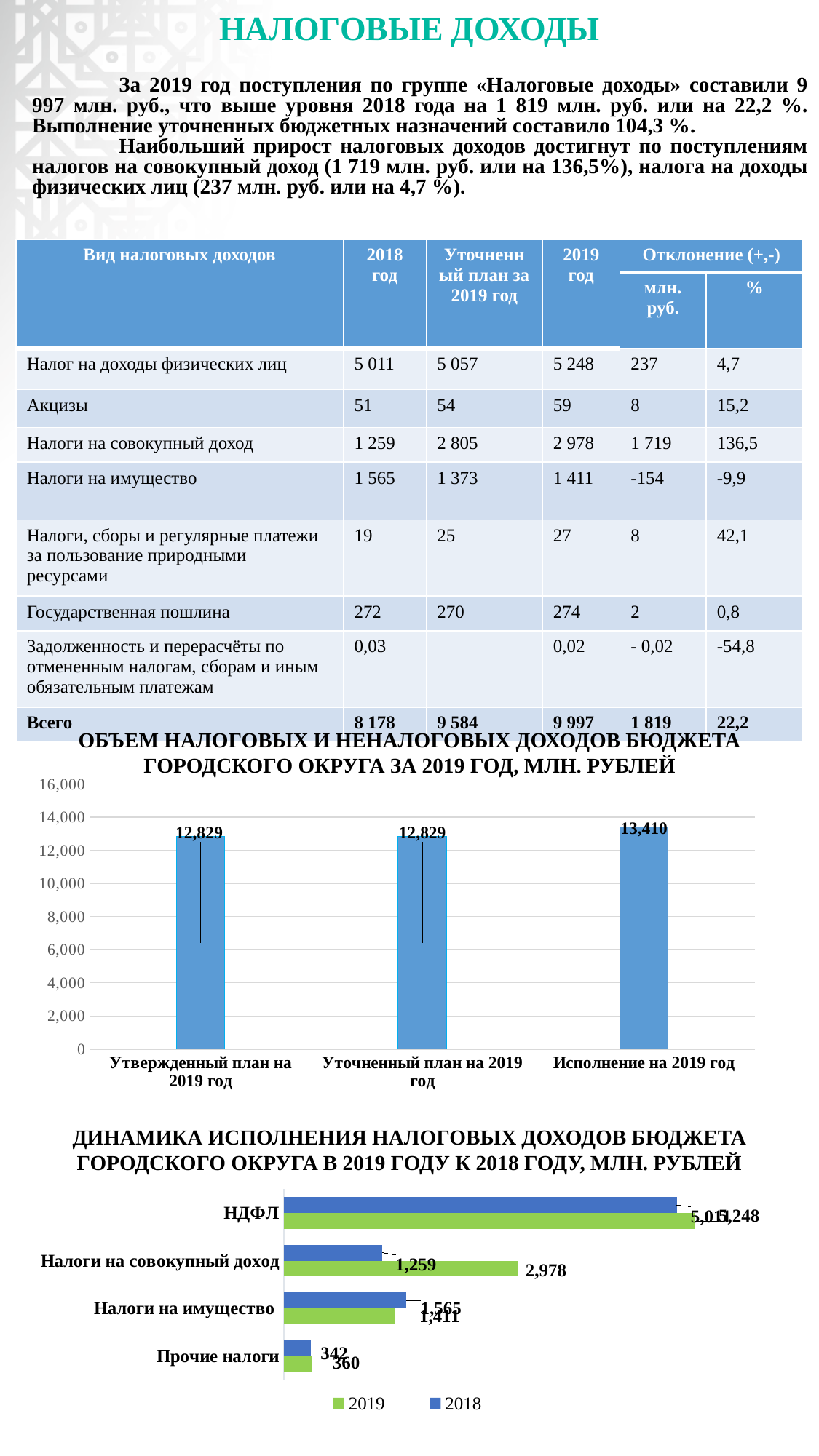
In the chart 'ОБЪЕМ НАЛОГОВЫХ И НЕНАЛОГОВЫХ ДОХОДОВ БЮДЖЕТА ГОРОДСКОГО ОКРУГА ЗА 2019 ГОД', what is the value for 'Утвержденный план на 2019 год'? 12,829 In the chart 'ОБЪЕМ НАЛОГОВЫХ И НЕНАЛОГОВЫХ ДОХОДОВ БЮДЖЕТА ГОРОДСКОГО ОКРУГА ЗА 2019 ГОД', which category has the highest value? Исполнение на 2019 год In the chart 'ОБЪЕМ НАЛОГОВЫХ И НЕНАЛОГОВЫХ ДОХОДОВ БЮДЖЕТА ГОРОДСКОГО ОКРУГА ЗА 2019 ГОД', what is the difference between 'Исполнение на 2019 год' and 'Уточненный план на 2019 год'? 581 In the chart 'ДИНАМИКА ИСПОЛНЕНИЯ НАЛОГОВЫХ ДОХОДОВ БЮДЖЕТА ГОРОДСКОГО ОКРУГА В 2019 ГОДУ К 2018 ГОДУ', which is larger for 'Налоги на совокупный доход': the 2018 value or the 2019 value? 2019 In the chart 'ОБЪЕМ НАЛОГОВЫХ И НЕНАЛОГОВЫХ ДОХОДОВ БЮДЖЕТА ГОРОДСКОГО ОКРУГА ЗА 2019 ГОД', what is the value for 'Исполнение на 2019 год'? 13,410 In the chart 'ДИНАМИКА ИСПОЛНЕНИЯ НАЛОГОВЫХ ДОХОДОВ БЮДЖЕТА ГОРОДСКОГО ОКРУГА В 2019 ГОДУ К 2018 ГОДУ', what is the 2019 value for 'Налоги на совокупный доход'? 2,978 In the chart 'ОБЪЕМ НАЛОГОВЫХ И НЕНАЛОГОВЫХ ДОХОДОВ БЮДЖЕТА ГОРОДСКОГО ОКРУГА ЗА 2019 ГОД', how many bars are plotted? 3 In the chart 'ДИНАМИКА ИСПОЛНЕНИЯ НАЛОГОВЫХ ДОХОДОВ БЮДЖЕТА ГОРОДСКОГО ОКРУГА В 2019 ГОДУ К 2018 ГОДУ', what is the difference between the 2019 and 2018 values for 'Налоги на совокупный доход'? 1,719 In the chart 'ДИНАМИКА ИСПОЛНЕНИЯ НАЛОГОВЫХ ДОХОДОВ БЮДЖЕТА ГОРОДСКОГО ОКРУГА В 2019 ГОДУ К 2018 ГОДУ', what is the 2018 value for 'Налоги на имущество'? 1,565 What kind of chart is 'ОБЪЕМ НАЛОГОВЫХ И НЕНАЛОГОВЫХ ДОХОДОВ БЮДЖЕТА ГОРОДСКОГО ОКРУГА ЗА 2019 ГОД'? Bar chart In the chart 'ДИНАМИКА ИСПОЛНЕНИЯ НАЛОГОВЫХ ДОХОДОВ БЮДЖЕТА ГОРОДСКОГО ОКРУГА В 2019 ГОДУ К 2018 ГОДУ', what is the 2019 value for 'Прочие налоги'? 360 How many series does the legend list in the chart 'ДИНАМИКА ИСПОЛНЕНИЯ НАЛОГОВЫХ ДОХОДОВ БЮДЖЕТА ГОРОДСКОГО ОКРУГА В 2019 ГОДУ К 2018 ГОДУ'? 2